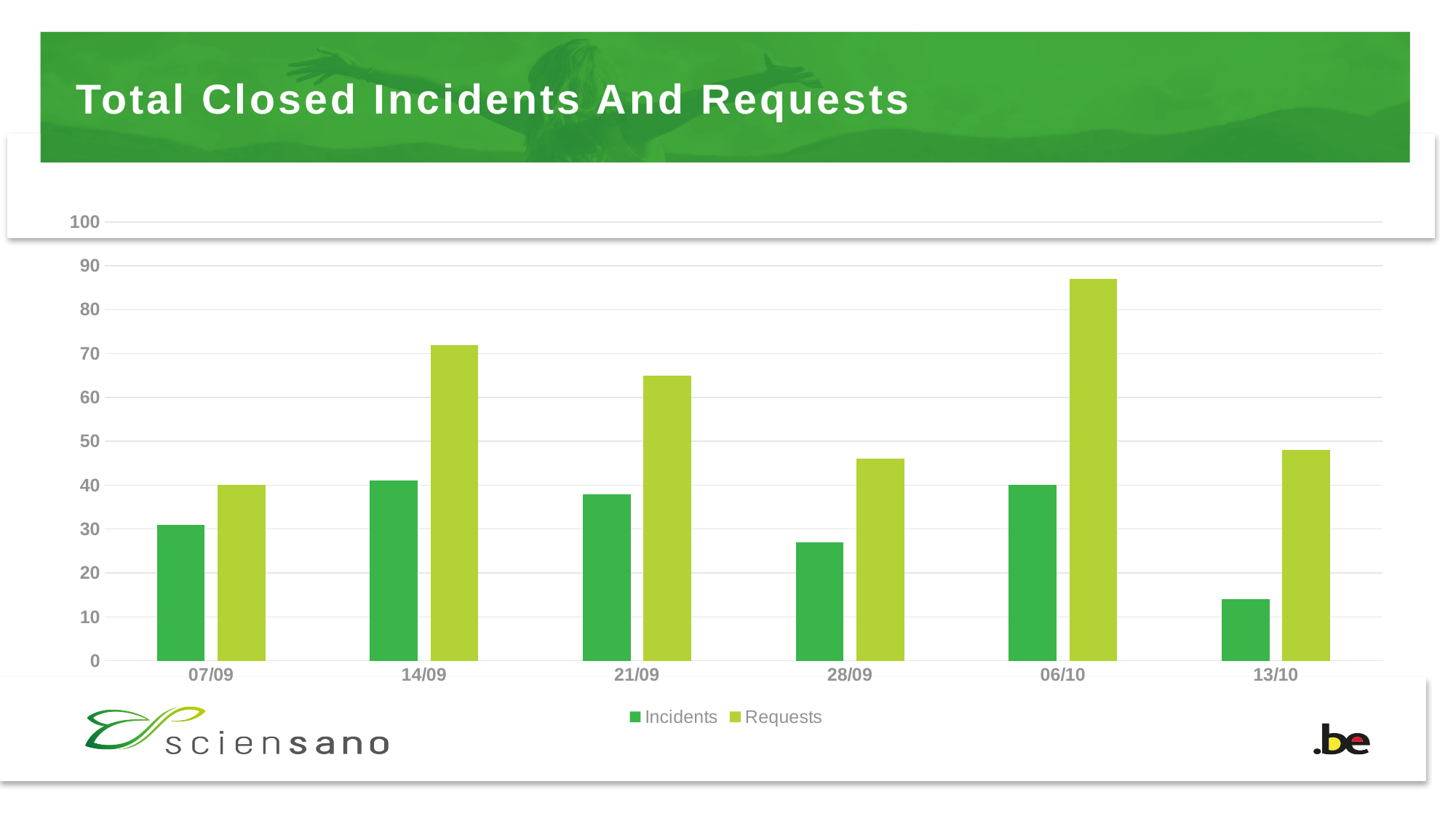
On which date is the Requests value lowest? 07/09 What kind of chart is shown on the slide? bar chart Is the Incidents value for 13/10 greater or less than 20? less How many dates are shown on the x axis? 6 On which date is the Requests value highest? 06/10 What is the title of the chart? Total Closed Incidents And Requests Which is larger on 14/09, Incidents or Requests? Requests On which date is the Incidents value lowest? 13/10 Is the Incidents value for 28/09 greater or less than 30? less Is the Requests value for 06/10 greater or less than 80? greater How many series does the legend list? 2